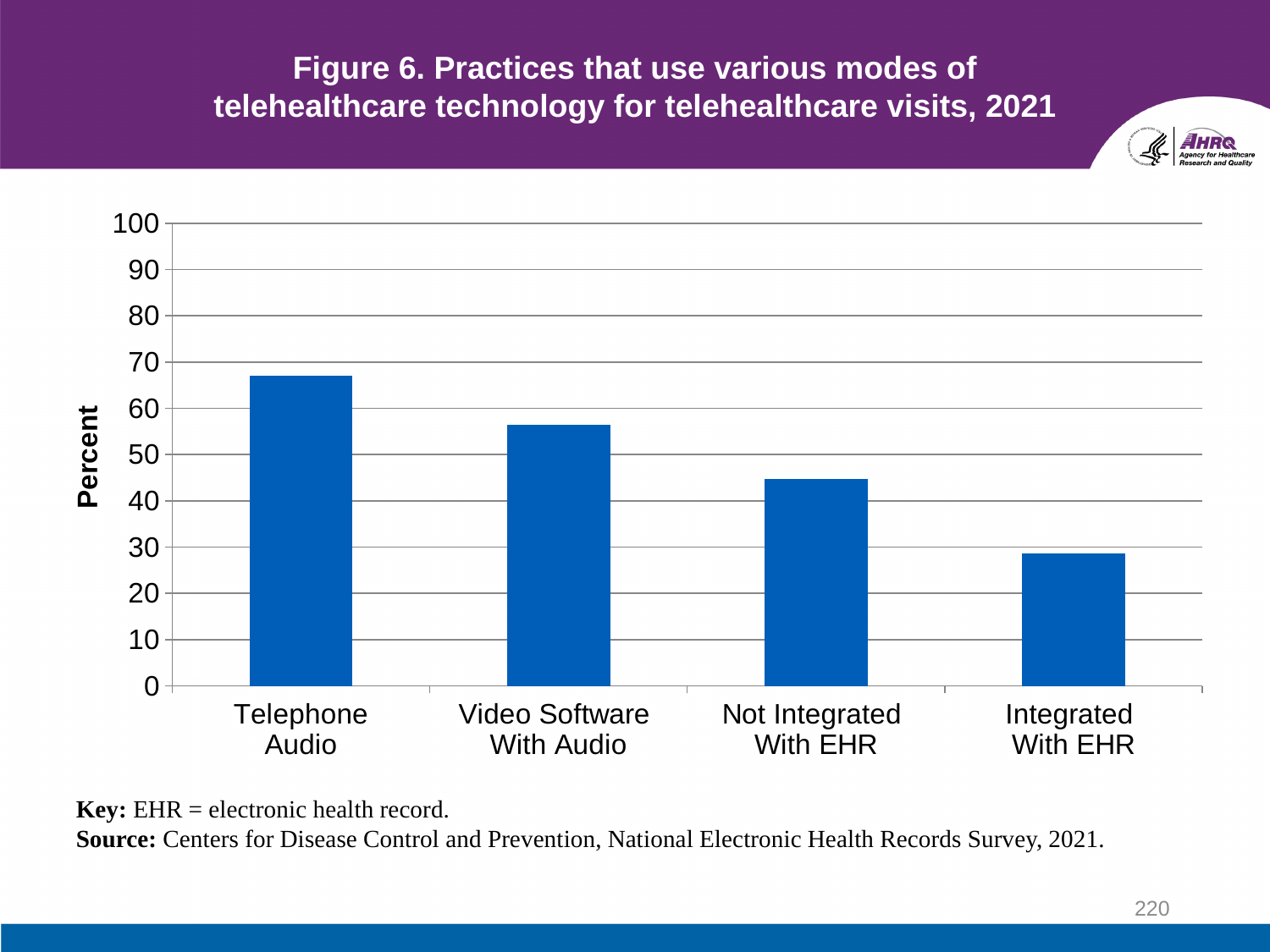
What is the label of the vertical axis of the chart? Percent Is the value for Telephone Audio greater or less than 70? less Which category has the lowest value in the chart? Integrated With EHR Is the value for Video Software With Audio greater or less than 50? greater Which category has the highest value in the chart? Telephone Audio Is the value for Telephone Audio greater or less than 60? greater What type of chart is shown on the slide? Bar chart How many categories are shown on the x axis of the chart? 4 Which is larger, the value for Video Software With Audio or the value for Not Integrated With EHR? Video Software With Audio Do the bar values rise or fall moving from left to right along the x axis? Fall